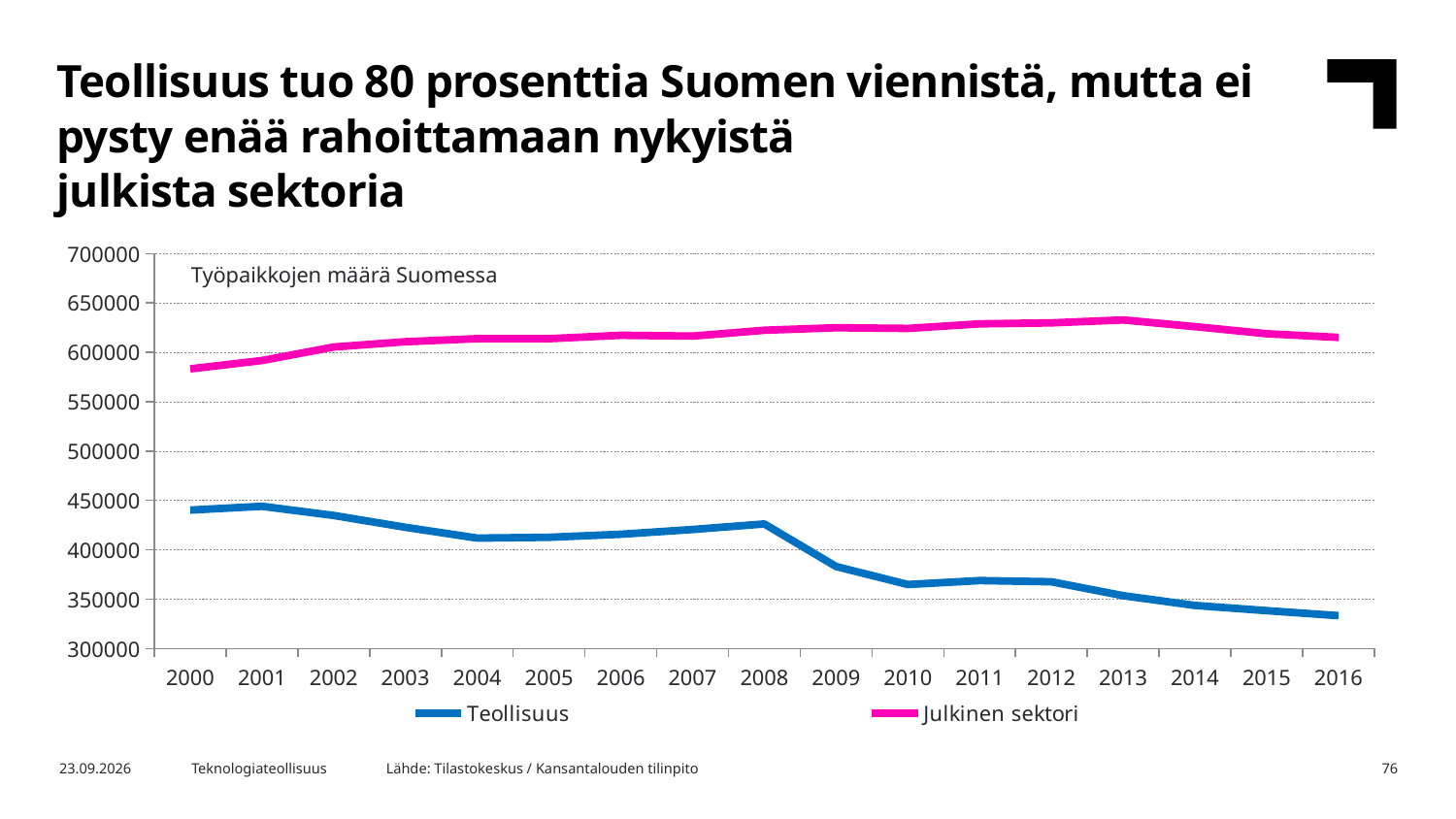
Is the value for Teollisuus in 2000 greater or less than 400000? greater What kind of chart is shown on the slide? line chart Does the Teollisuus series rise or fall overall from 2000 to 2016? fall Which series has higher values throughout the chart, Teollisuus or Julkinen sektori? Julkinen sektori Is the value for Julkinen sektori in 2000 greater or less than 600000? less How many years are shown on the x axis? 17 In which year is the Julkinen sektori series at its highest? 2013 In which year is the Teollisuus series at its lowest? 2016 What is the title printed inside the chart area? Työpaikkojen määrä Suomessa Is the value for Julkinen sektori in 2013 greater or less than 600000? greater How many series does the legend list? 2